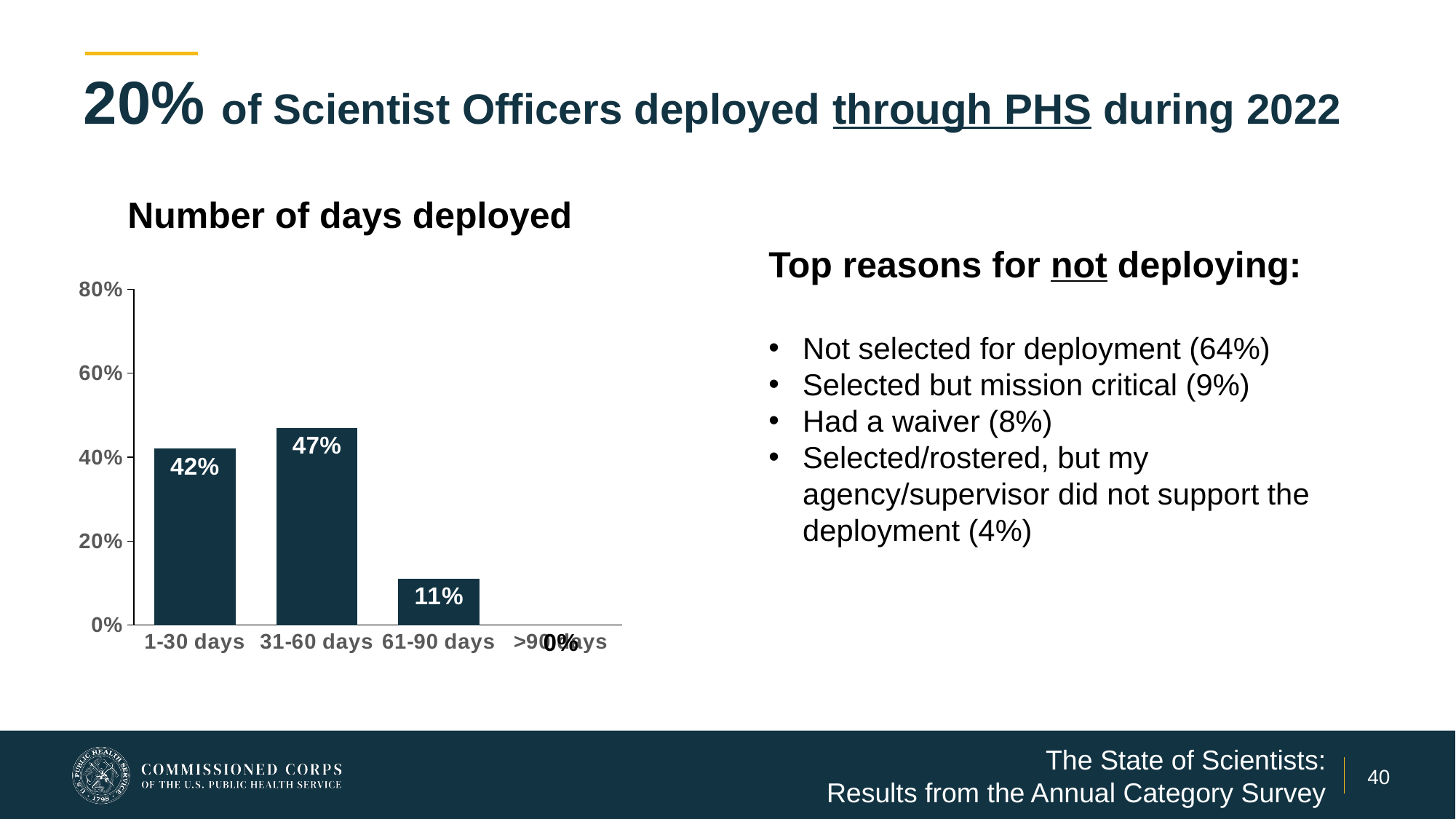
What is the difference between the values for 1-30 days and 61-90 days? 31% Which category has the highest value in the Number of days deployed chart? 31-60 days What is the value for >90 days in the Number of days deployed chart? 0% What kind of chart is the Number of days deployed chart? bar chart Which is larger, the value for 1-30 days or the value for 61-90 days? 1-30 days What is the value for 31-60 days in the Number of days deployed chart? 47% How many categories are shown on the x axis of the Number of days deployed chart? 4 What is the difference between the values for 31-60 days and 1-30 days? 5% What is the value for 1-30 days in the Number of days deployed chart? 42% Which category has the lowest value in the Number of days deployed chart? >90 days What is the value for 61-90 days in the Number of days deployed chart? 11% Is the value for 61-90 days greater or less than 20%? less